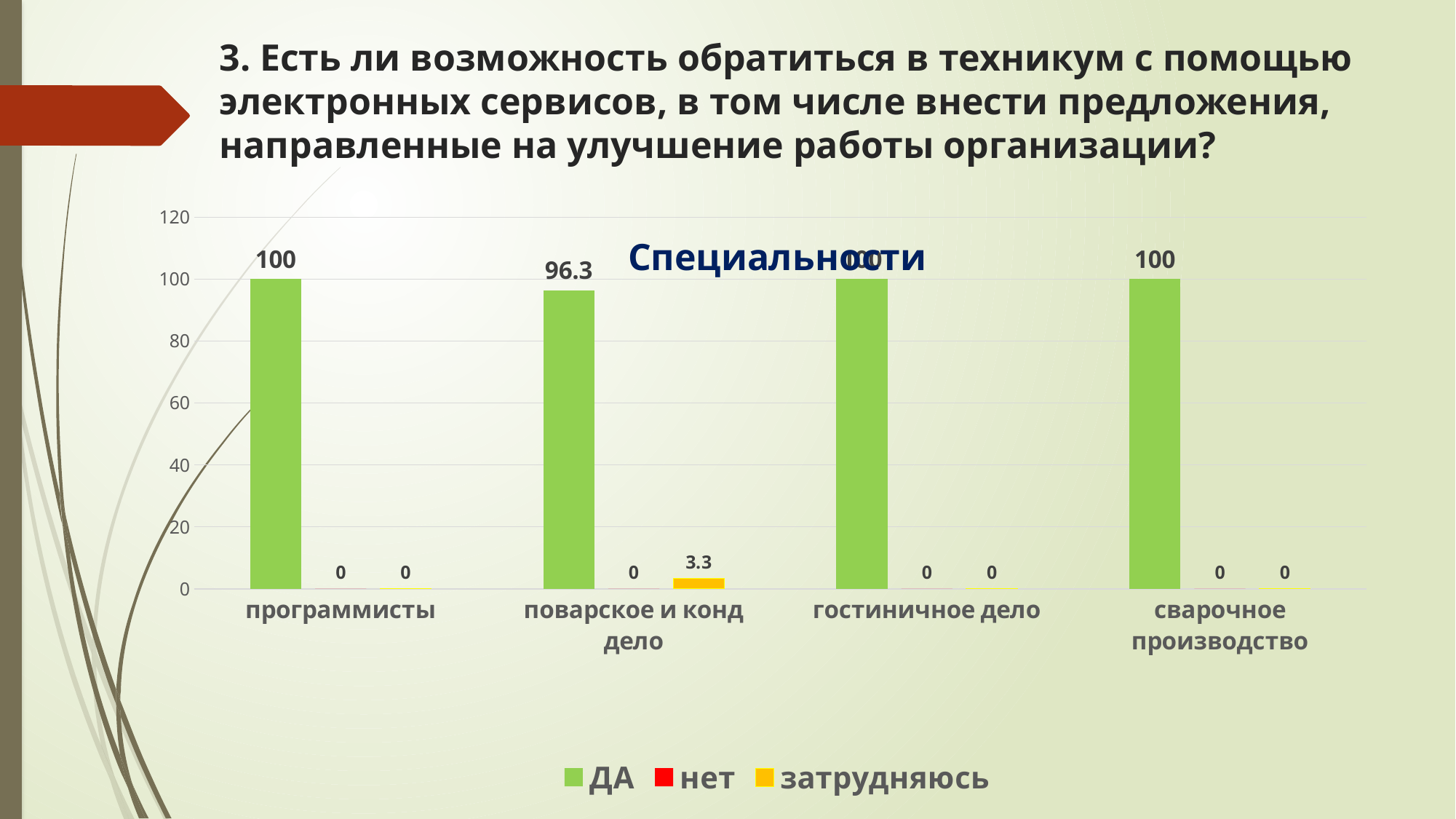
Which is larger for поварское и конд дело: the value of ДА or the value of затрудняюсь? ДА How many series does the legend list? 3 How many categories are shown on the x axis? 4 What is the value of ДА for поварское и конд дело? 96.3 What type of chart is shown on the slide? bar chart What is the value of ДА for программисты? 100 What is the value of нет for сварочное производство? 0 What is the difference between the ДА values for программисты and поварское и конд дело? 3.7 Is the value of ДА for поварское и конд дело greater or less than 80? greater What colour are the bars for the ДА series? green Which category has the lowest value for ДА? поварское и конд дело What is the value of затрудняюсь for поварское и конд дело? 3.3